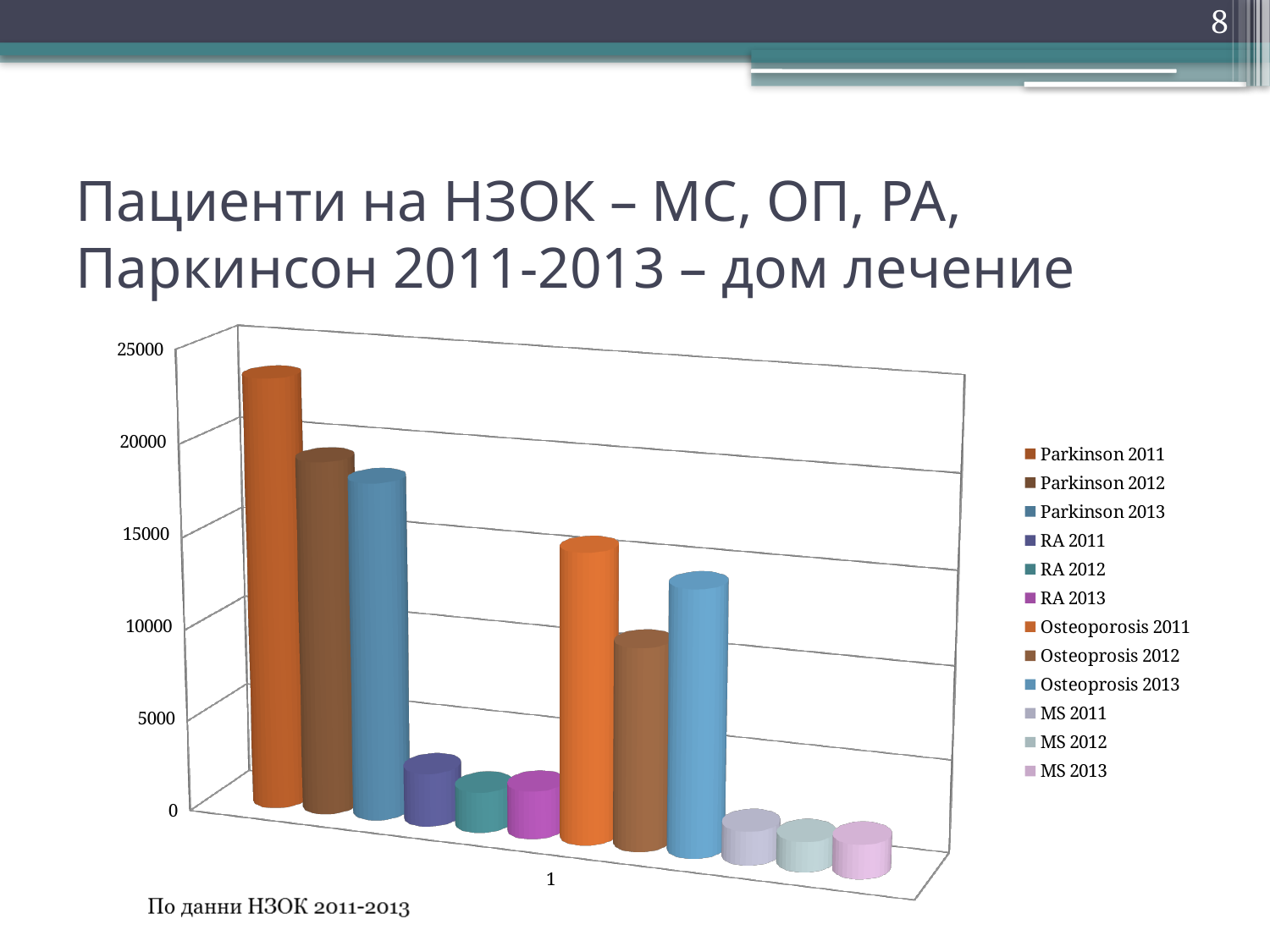
Is the value for RA 2011 greater or less than 5000? less Is the value for Parkinson 2011 greater or less than 20000? greater Which is larger, the value for Parkinson 2011 or the value for Osteoporosis 2011? Parkinson 2011 Which is larger, the value for Osteoprosis 2013 or the value for Osteoprosis 2012? Osteoprosis 2013 How many series does the legend list? 12 What kind of chart is shown on the slide? bar chart Is the value for Osteoprosis 2012 greater or less than 15000? less Which series has the highest value in the chart? Parkinson 2011 Do the Parkinson values rise or fall from 2011 to 2013? fall